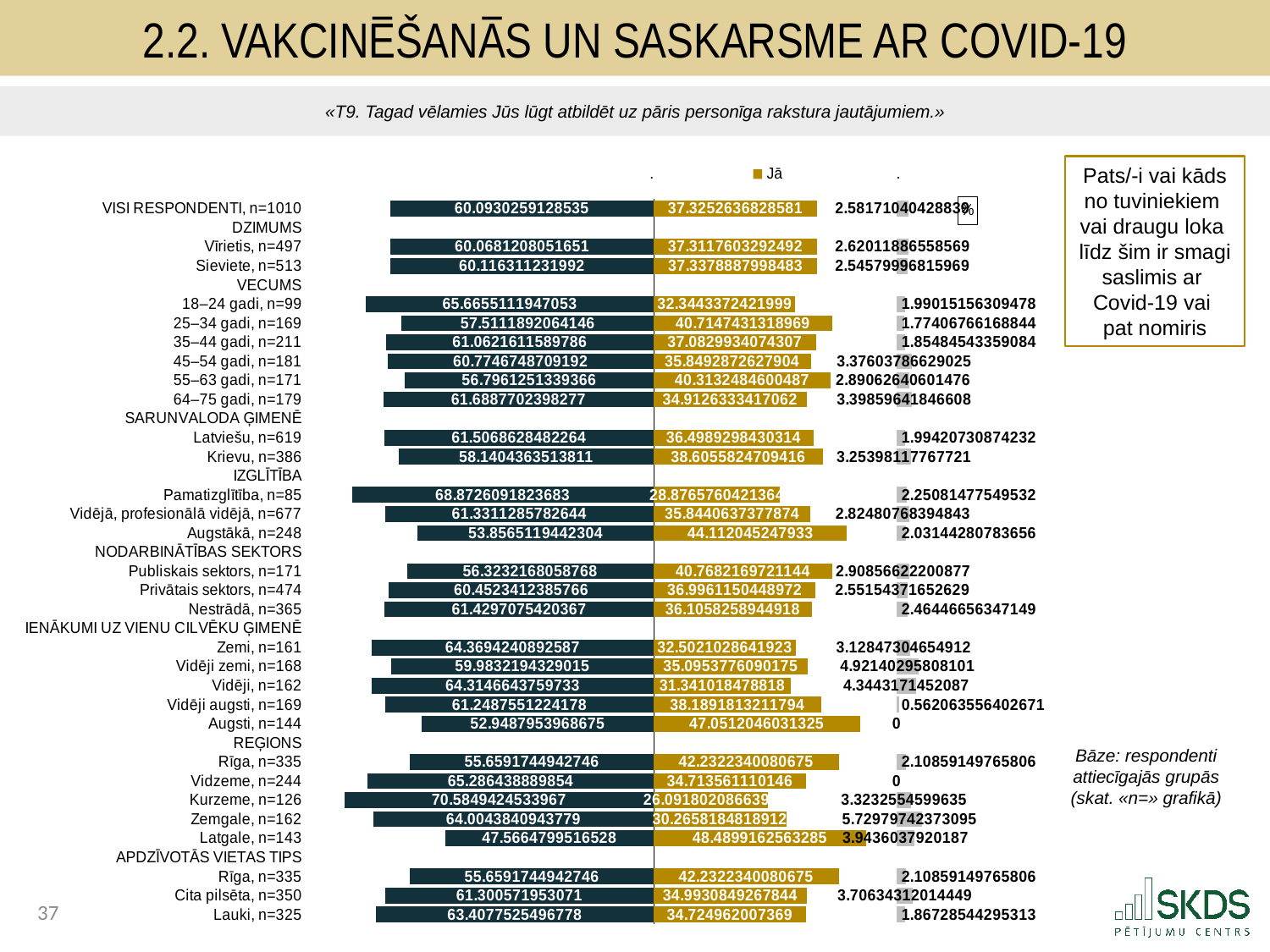
Among the IZGLĪTĪBA groups, which has the highest "Jā" value? Augstākā, n=248 Which has the larger "Jā" value: "18–24 gadi, n=99" or "25–34 gadi, n=169"? 25–34 gadi, n=169 What question text is shown in the box to the right of the chart? Pats/-i vai kāds no tuviniekiem vai draugu loka līdz šim ir smagi saslimis ar Covid-19 vai pat nomiris What is the value of the dark first segment for "Pamatizglītība, n=85"? 68.8726091823683 Among the REĢIONS groups (Rīga, Vidzeme, Kurzeme, Zemgale, Latgale), which has the highest "Jā" value? Latgale, n=143 What is the "Jā" value for "Kurzeme, n=126"? 26.091802086639 What is the difference between the "Jā" values for "Latgale, n=143" and "Kurzeme, n=126"? 22.3981141696895 Among the REĢIONS groups (Rīga, Vidzeme, Kurzeme, Zemgale, Latgale), which has the lowest "Jā" value? Kurzeme, n=126 What kind of chart is shown on the slide? bar chart What is the "Jā" value for the group "Augsti, n=144"? 47.0512046031325 What is the value of the third (grey) segment for "Vidzeme, n=244"? 0 What is the value of the third (grey) segment for "Vidēji zemi, n=168"? 4.92140295808101